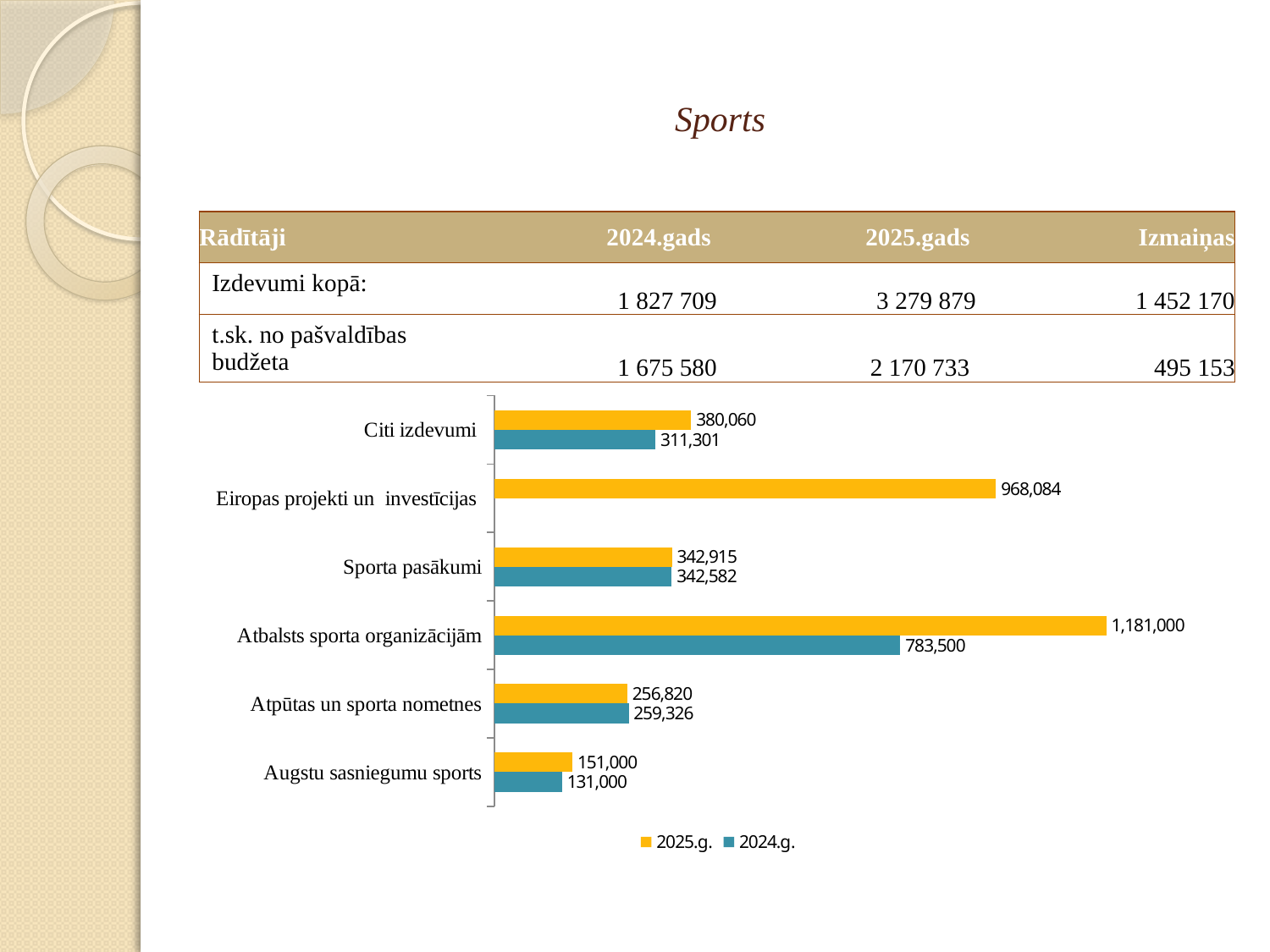
Which category has the highest 2025.g. value? Atbalsts sporta organizācijām What is the 2024.g. value for Citi izdevumi? 311,301 How many categories are shown on the chart? 6 What kind of chart is shown on the slide? Bar chart What is the difference between the 2025.g. and 2024.g. values for Augstu sasniegumu sports? 20,000 For Citi izdevumi, which is larger: the 2025.g. value or the 2024.g. value? 2025.g. Which category has the lowest 2024.g. value? Augstu sasniegumu sports What is the difference between the 2025.g. and 2024.g. values for Atbalsts sporta organizācijām? 397,500 How many series does the legend list? 2 What is the 2024.g. value for Atpūtas un sporta nometnes? 259,326 What is the 2025.g. value for Eiropas projekti un investīcijas? 968,084 What is the 2025.g. value for Atbalsts sporta organizācijām? 1,181,000